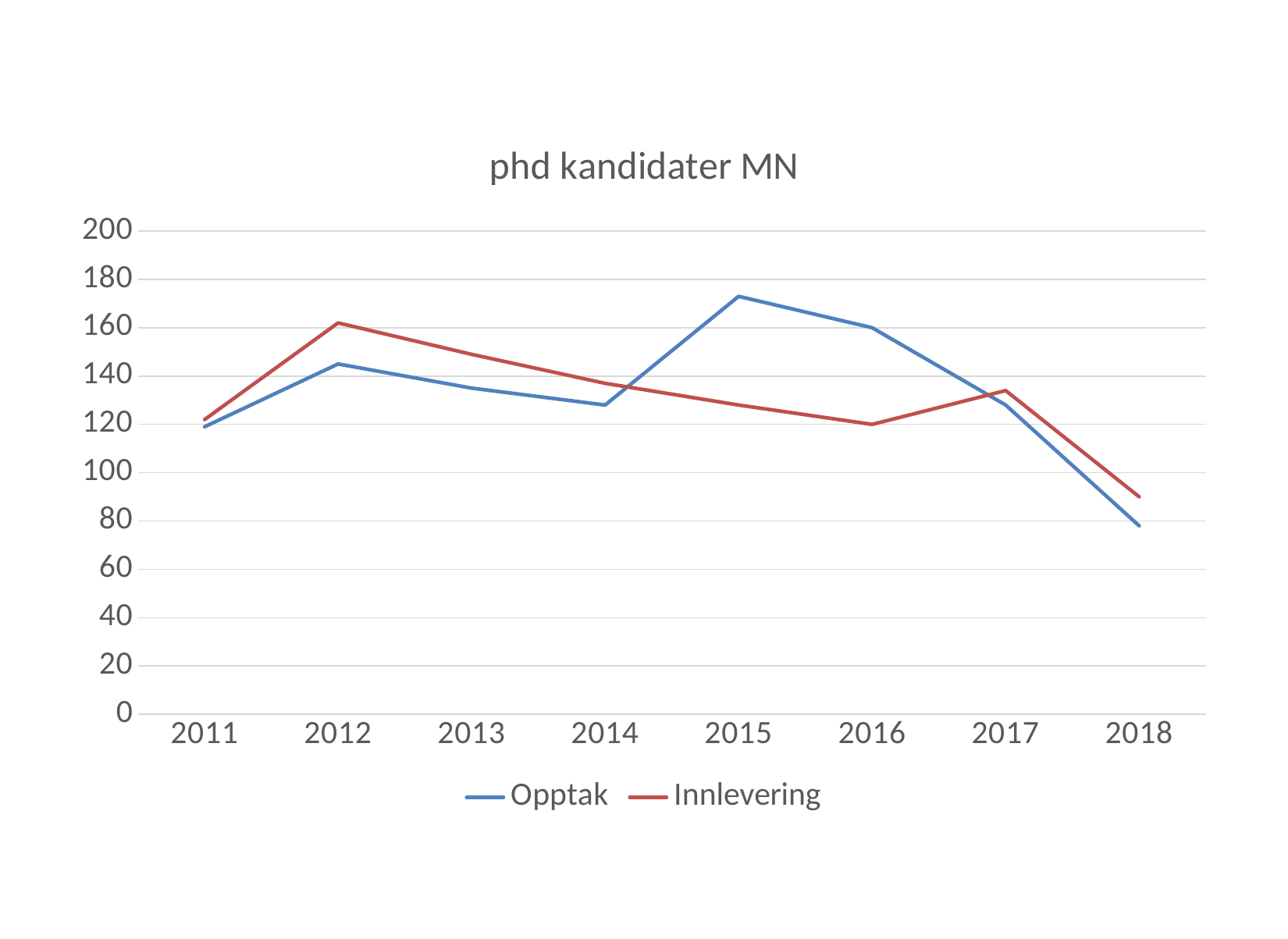
How many series does the legend list? 2 In 2012, which series has the larger value, Opptak or Innlevering? Innlevering How many years are shown on the x axis? 8 Is the Innlevering value for 2016 greater or less than 140? less What is the title of the chart? phd kandidater MN In which year is the Opptak value highest? 2015 What kind of chart is shown on the slide? line chart In which year is the Innlevering value lowest? 2018 In which year is the Innlevering value highest? 2012 In which year is the Opptak value lowest? 2018 Do the Opptak values rise or fall from 2016 to 2018? fall Is the Opptak value for 2015 greater or less than 160? greater